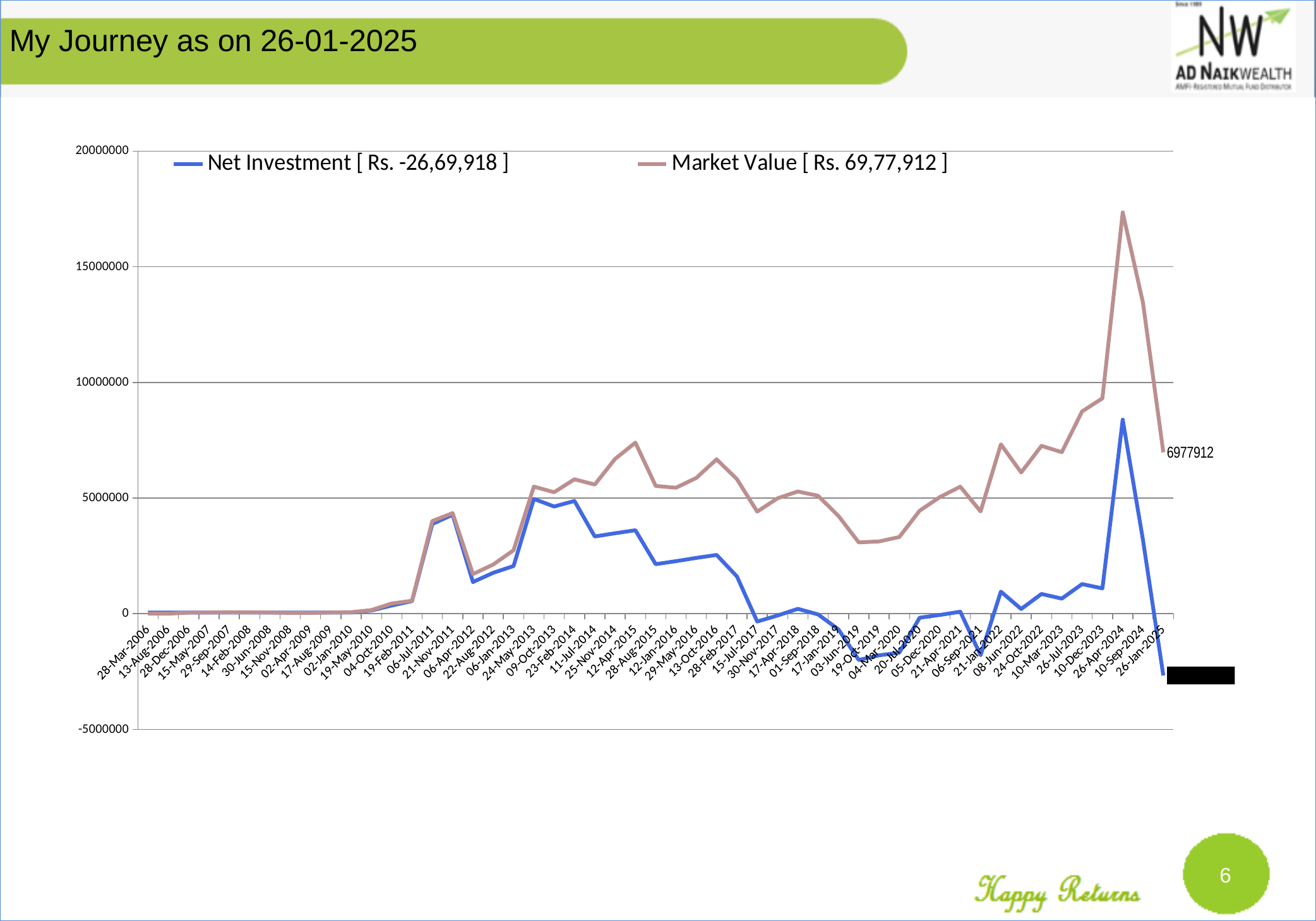
What is the full legend entry for the brown line? Market Value [ Rs. 69,77,912 ] Does the Market Value rise or fall between 26-Apr-2024 and 26-Jan-2025? fall Is the Net Investment at 26-Apr-2024 greater or less than 10000000? less What is the full legend entry for the blue line? Net Investment [ Rs. -26,69,918 ] How many series does the legend list? 2 What kind of chart is shown on the slide? line chart Is the Market Value at 12-Apr-2015 greater or less than 5000000? greater Is the Net Investment at 26-Jan-2025 greater or less than 0? less What is the labelled Market Value at 26-Jan-2025? 6977912 At 26-Jan-2025, which series has the higher value, Net Investment or Market Value? Market Value Which series reaches the highest value anywhere on the chart? Market Value